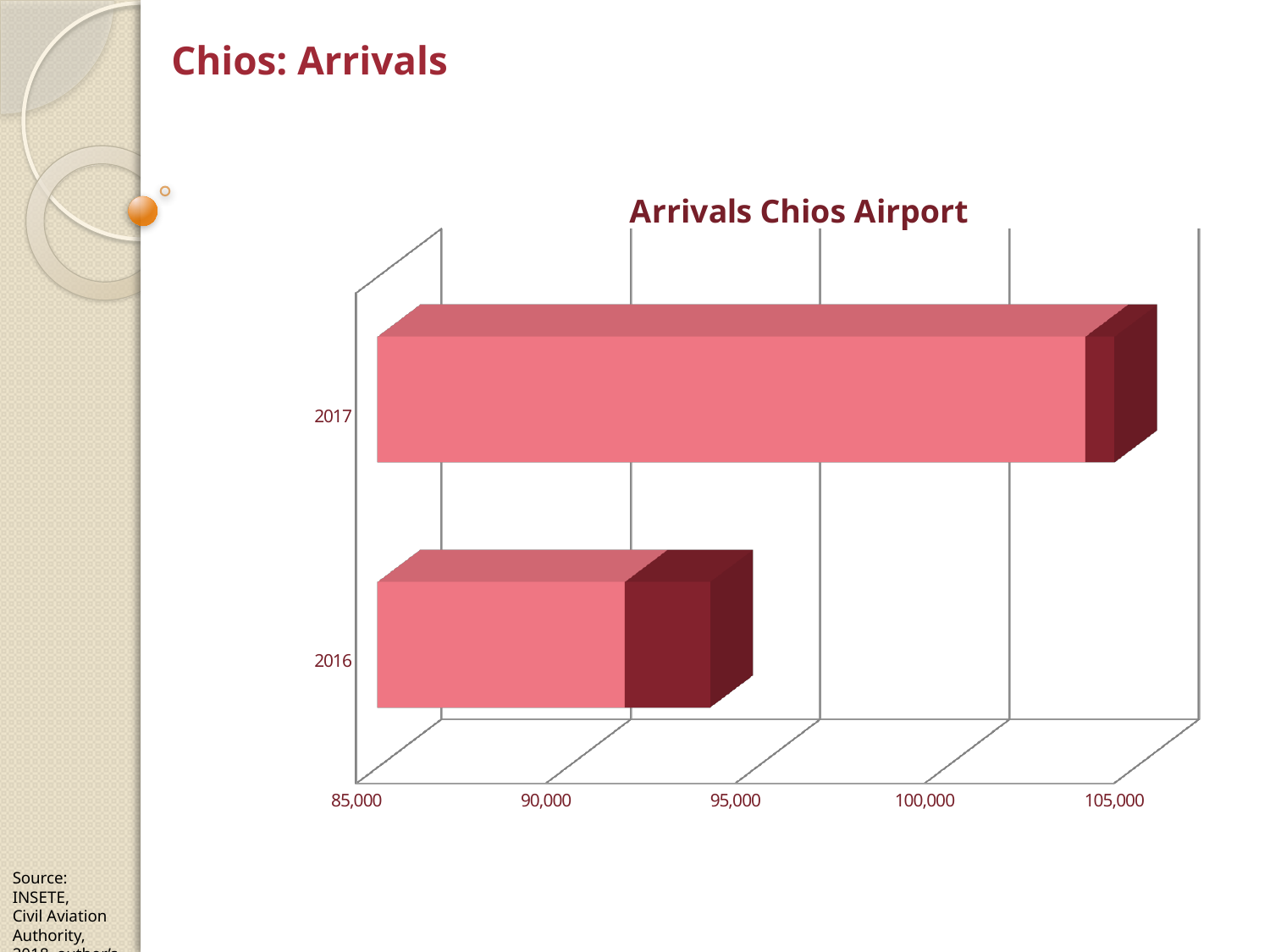
Which year has the lowest arrivals at Chios Airport? 2016 What is the title of the chart? Arrivals Chios Airport How many years are shown in the chart? 2 What type of chart is shown on the slide? bar chart Which year has the highest arrivals at Chios Airport? 2017 Did arrivals at Chios Airport rise or fall from 2016 to 2017? rise What is the lowest value shown on the horizontal axis? 85,000 Which year has more arrivals, 2016 or 2017? 2017 Is the value for 2016 greater or less than 95,000? less Is the value for 2017 greater or less than 100,000? greater